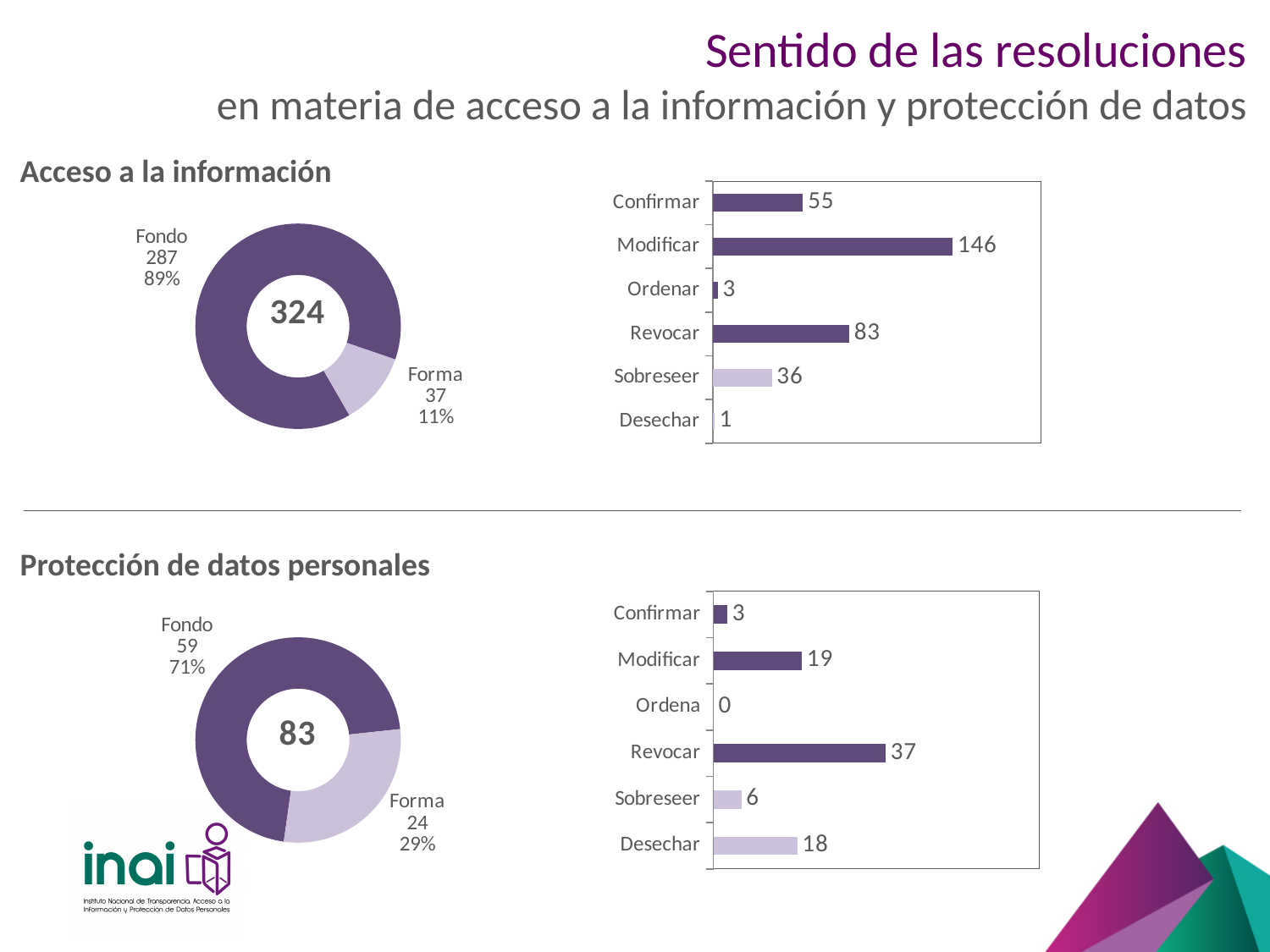
In the bar chart under 'Acceso a la información', what is the value for Modificar? 146 In the donut chart under 'Acceso a la información', what is the total shown in the centre? 324 What kind of chart is shown on the right side under 'Protección de datos personales'? Bar chart In the bar chart under 'Acceso a la información', which category has the lowest value? Desechar In the bar chart under 'Protección de datos personales', which is larger, Modificar or Desechar? Modificar In the bar chart under 'Acceso a la información', which category has the highest value? Modificar In the bar chart under 'Acceso a la información', what is the difference between Modificar and Revocar? 63 In the bar chart under 'Protección de datos personales', what is the value for Revocar? 37 In the donut chart under 'Protección de datos personales', what is the value for Forma? 24 In the bar chart under 'Protección de datos personales', which category has the lowest value? Ordena In the bar chart under 'Acceso a la información', how many categories are shown? 6 In the donut chart under 'Acceso a la información', what share does Fondo represent? 89%